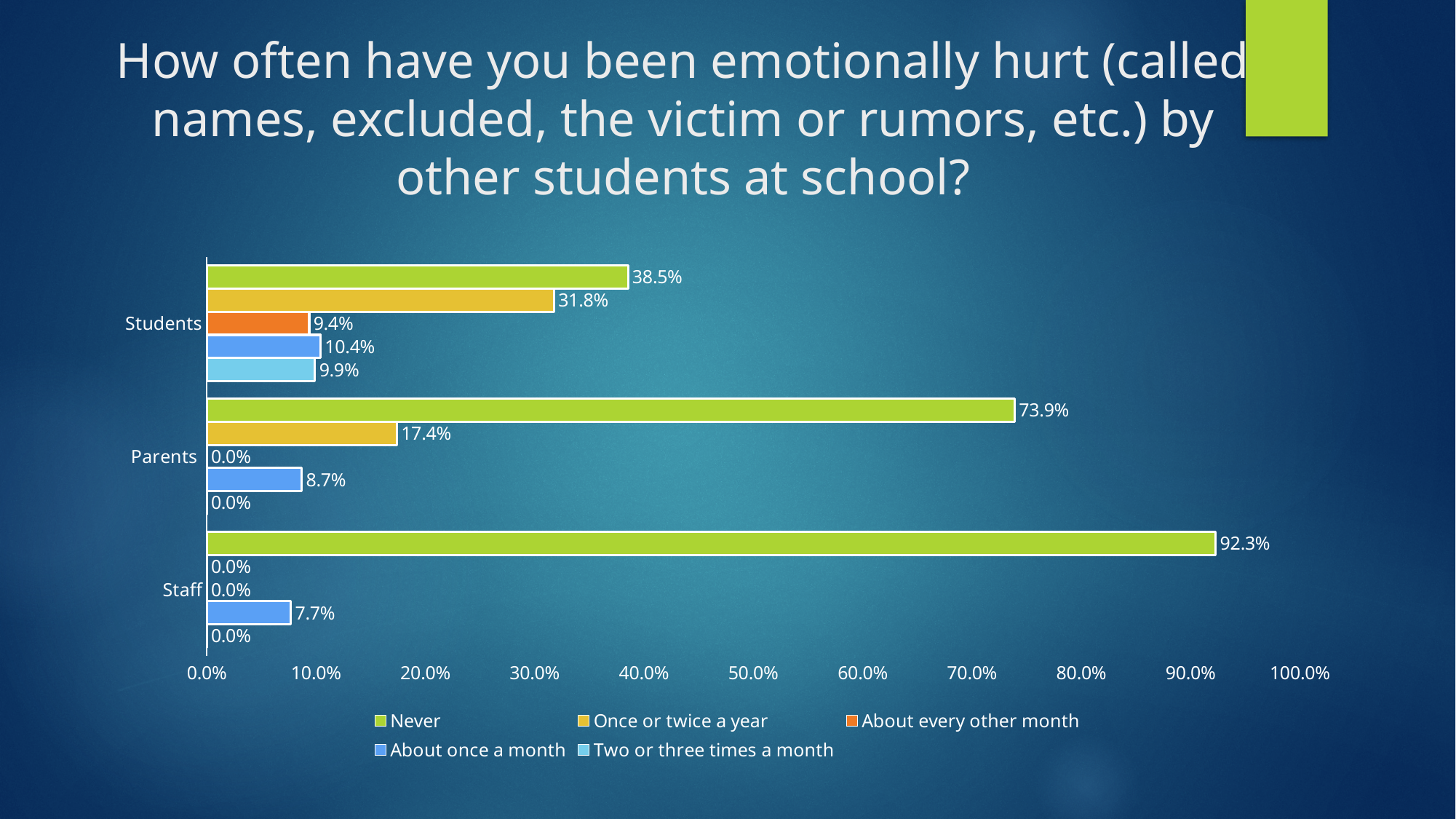
What is the value for Parents in the "Once or twice a year" series? 17.4% Which is larger for Students: "About once a month" or "About every other month"? About once a month What is the value for Staff in the "About once a month" series? 7.7% How many groups are shown on the vertical axis? 3 How many series does the legend list? 5 What kind of chart is shown on the slide? Bar chart What percentage of Students answered "Never"? 38.5% What is the value for Students in the "Two or three times a month" series? 9.9% Which series is shown in green in the legend? Never What is the difference between the "Never" values for Staff and Parents? 18.4% Which group has the highest value for "Never"? Staff Which group has the lowest value for "Never"? Students